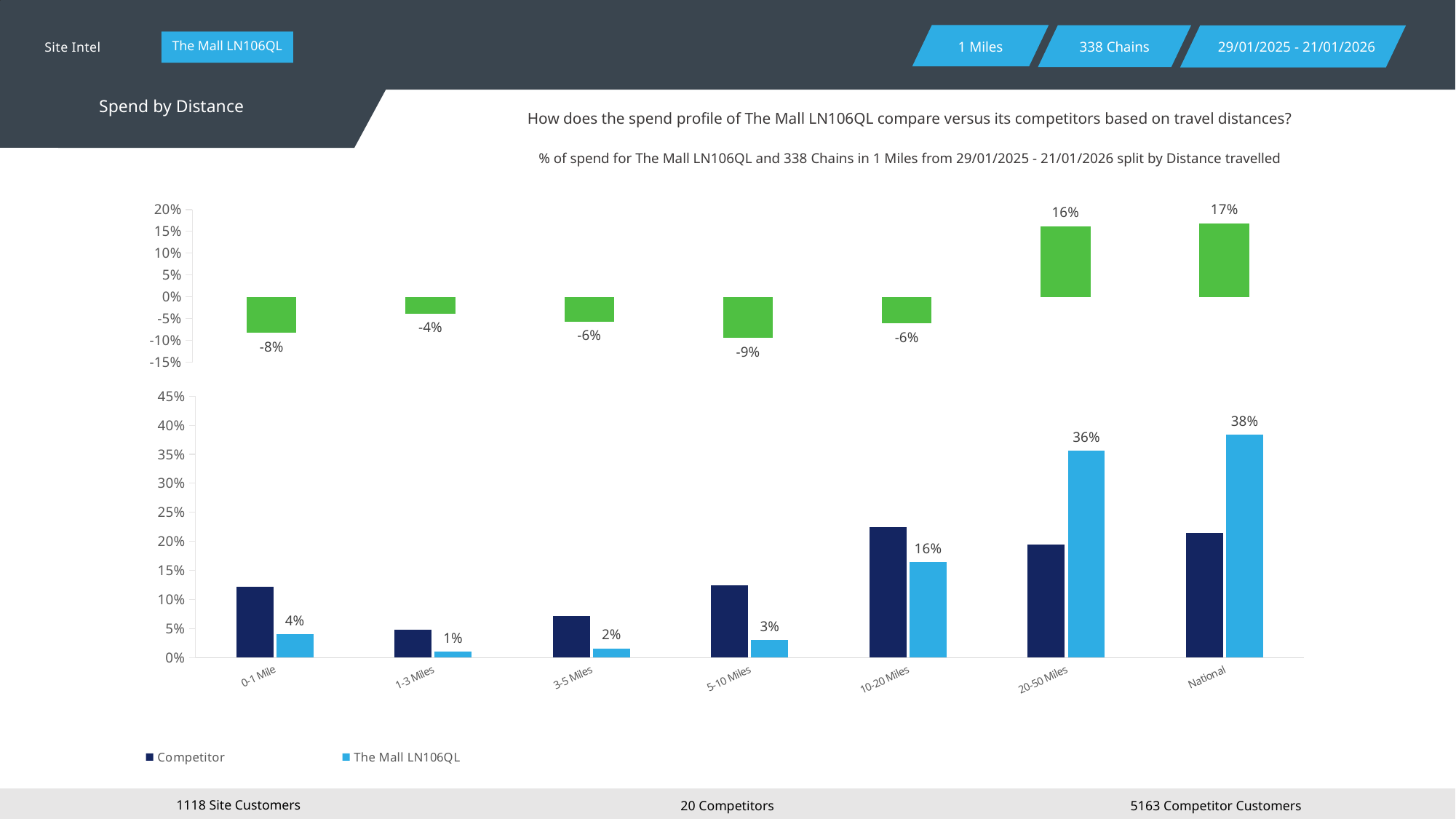
In the top chart, which category has the lowest value? 5-10 Miles How many series does the legend of the bottom chart list? 2 In the bottom chart, what is the value for The Mall LN106QL for 20-50 Miles? 36% In the top chart, which category has the highest value? National In the bottom chart, is the Competitor value for 10-20 Miles greater or less than 20%? greater In the top chart, what is the value shown for 5-10 Miles? -9% In the bottom chart, what is the difference between The Mall LN106QL values for National and 20-50 Miles? 2% How many distance categories are shown on the x axis of the bottom chart? 7 In the bottom chart, which category has the lowest value for The Mall LN106QL? 1-3 Miles In the bottom chart, what is the value for The Mall LN106QL in the National category? 38% In the bottom chart, for 0-1 Mile, which series has the larger value: Competitor or The Mall LN106QL? Competitor What kind of chart is the bottom chart? bar chart